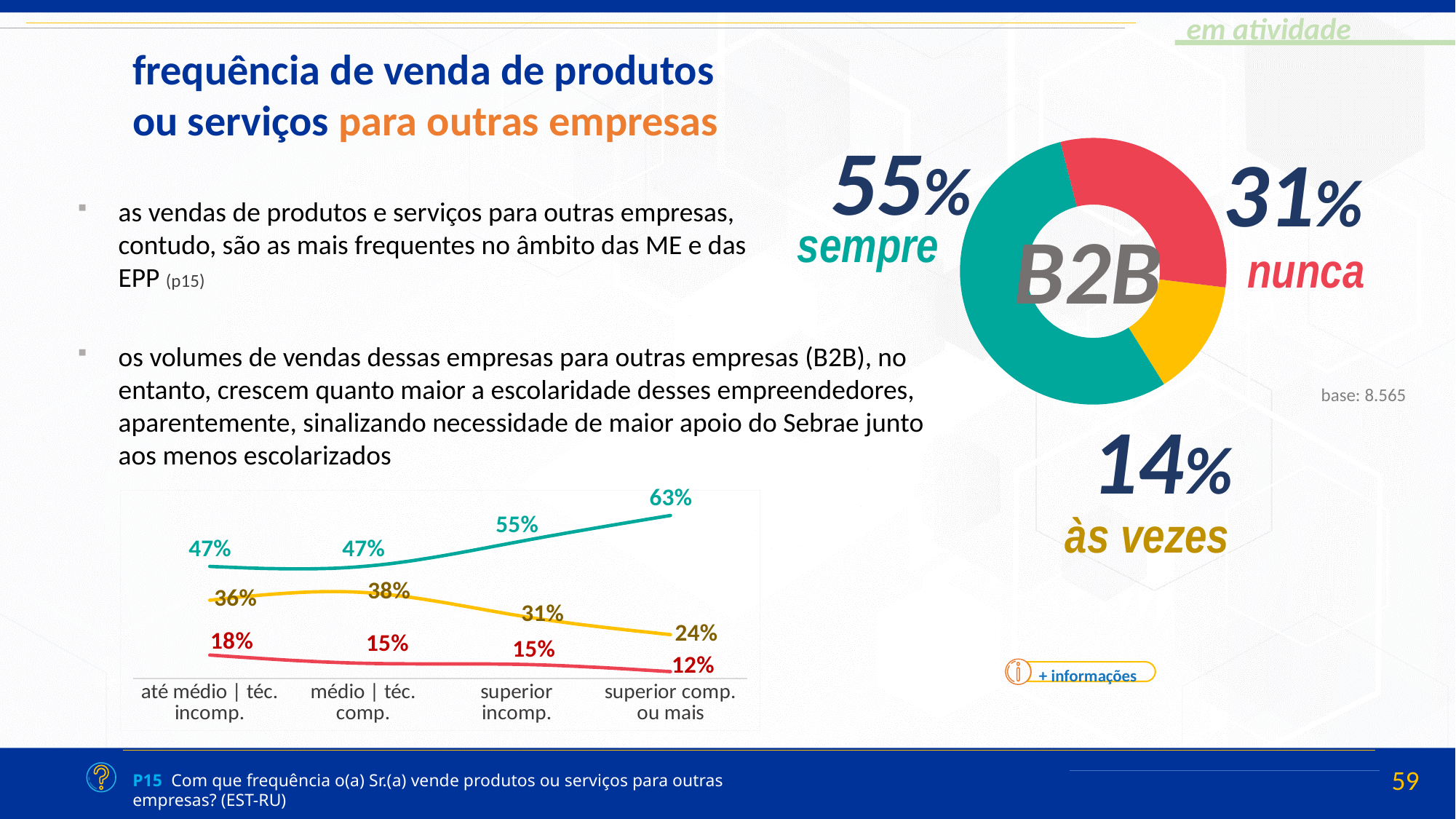
In the donut chart labelled B2B, what percentage is shown for "sempre"? 55% In the line chart at the bottom left, what is the difference between the green line and the red line at "superior incomp."? 40 percentage points In the donut chart labelled B2B, what percentage is shown for "nunca"? 31% In the line chart at the bottom left, how many education categories are shown on the x axis? 4 In the donut chart labelled B2B, which category has the smallest share? às vezes In the line chart at the bottom left, what value does the red line show for "até médio | téc. incomp."? 18% In the donut chart labelled B2B, what is the difference in percentage points between "sempre" and "nunca"? 24 What type of chart is shown at the bottom left of the slide? line chart In the line chart at the bottom left, what value does the green line show for "superior comp. ou mais"? 63% In the donut chart labelled B2B, what base (sample size) is stated? 8.565 In the line chart at the bottom left, what value does the yellow line show for "médio | téc. comp."? 38% In the line chart at the bottom left, does the green line rise or fall from left to right? rise